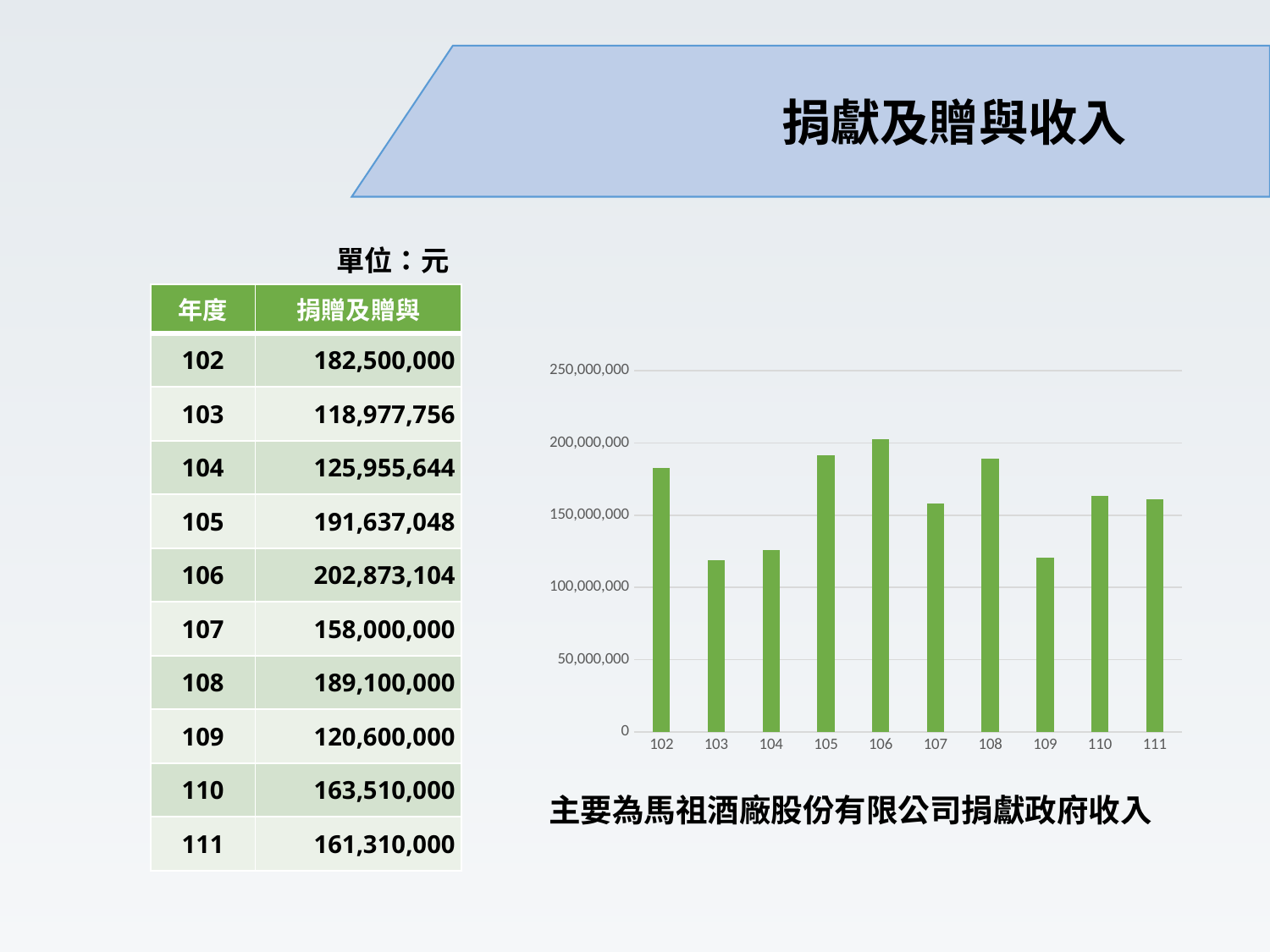
How many years (bars) are shown in the chart? 10 What type of chart is shown on the slide? bar chart What is the 捐贈及贈與 value for year 106? 202,873,104 What is the 捐贈及贈與 value for year 109? 120,600,000 Which is larger, the value for year 105 or the value for year 108? 105 What unit is stated for the values on the slide? 元 Which year has the highest 捐贈及贈與 value? 106 What is the difference between the values for year 110 and year 111? 2,200,000 Is the value for year 106 greater or less than 200,000,000? greater Is the value for year 103 greater or less than 150,000,000? less What is the 捐贈及贈與 value for year 111? 161,310,000 Which year has the lowest 捐贈及贈與 value? 103